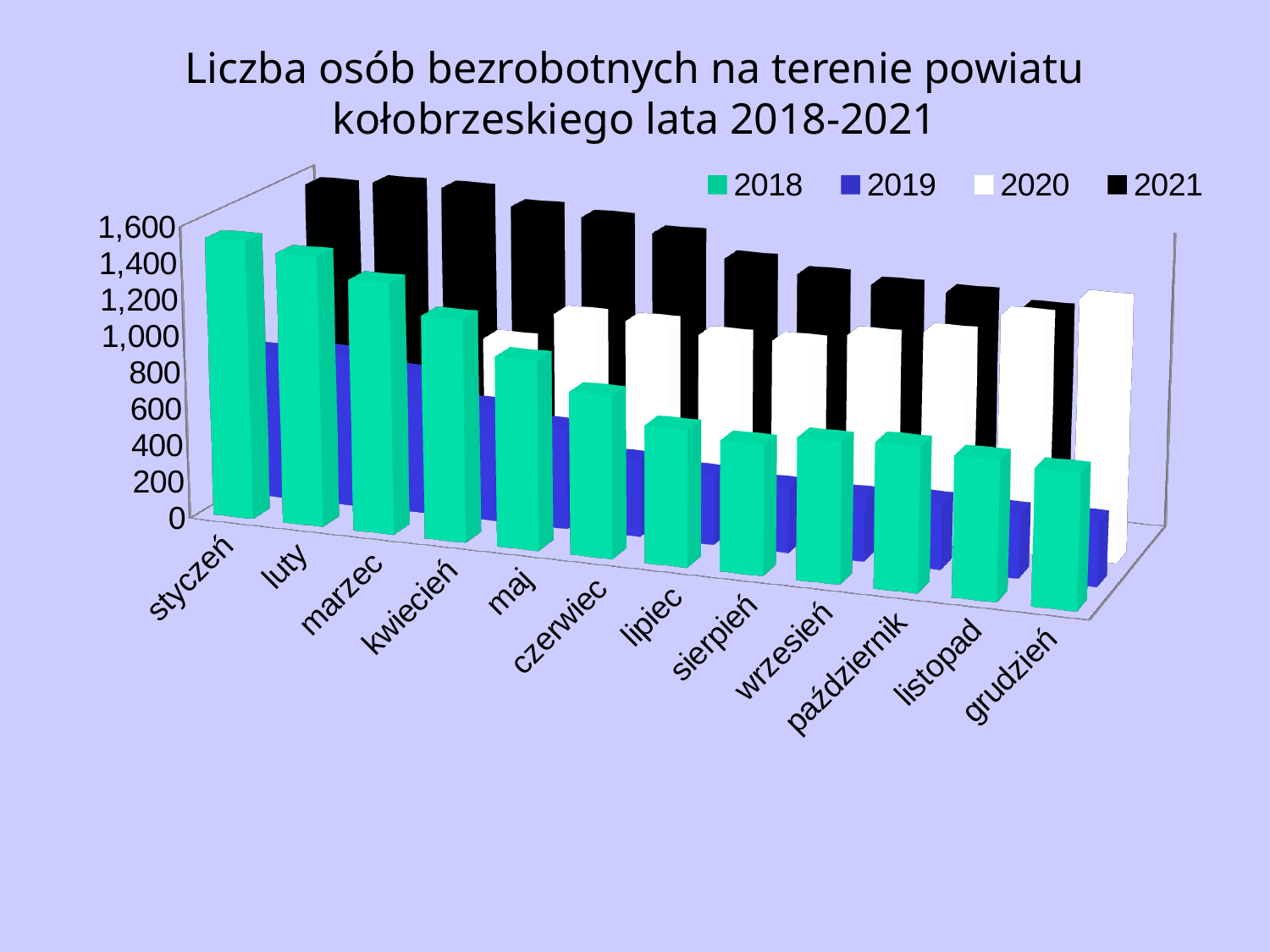
How many months (categories) are shown on the x axis? 12 What kind of chart is shown on the slide? bar chart What is the title of the chart? Liczba osób bezrobotnych na terenie powiatu kołobrzeskiego lata 2018-2021 Which is larger for the 2018 series: styczeń or grudzień? styczeń How many series does the legend list? 4 Is the value for 2018 in styczeń greater or less than 1,000? greater Do the values for the 2018 series rise or fall from styczeń to grudzień? fall Which years are listed in the legend? 2018, 2019, 2020, 2021 Which is larger for the 2018 series: marzec or lipiec? marzec In which month is the 2018 series highest? styczeń Is the value for 2018 in grudzień greater or less than 800? less What is the highest value shown on the vertical axis? 1,600